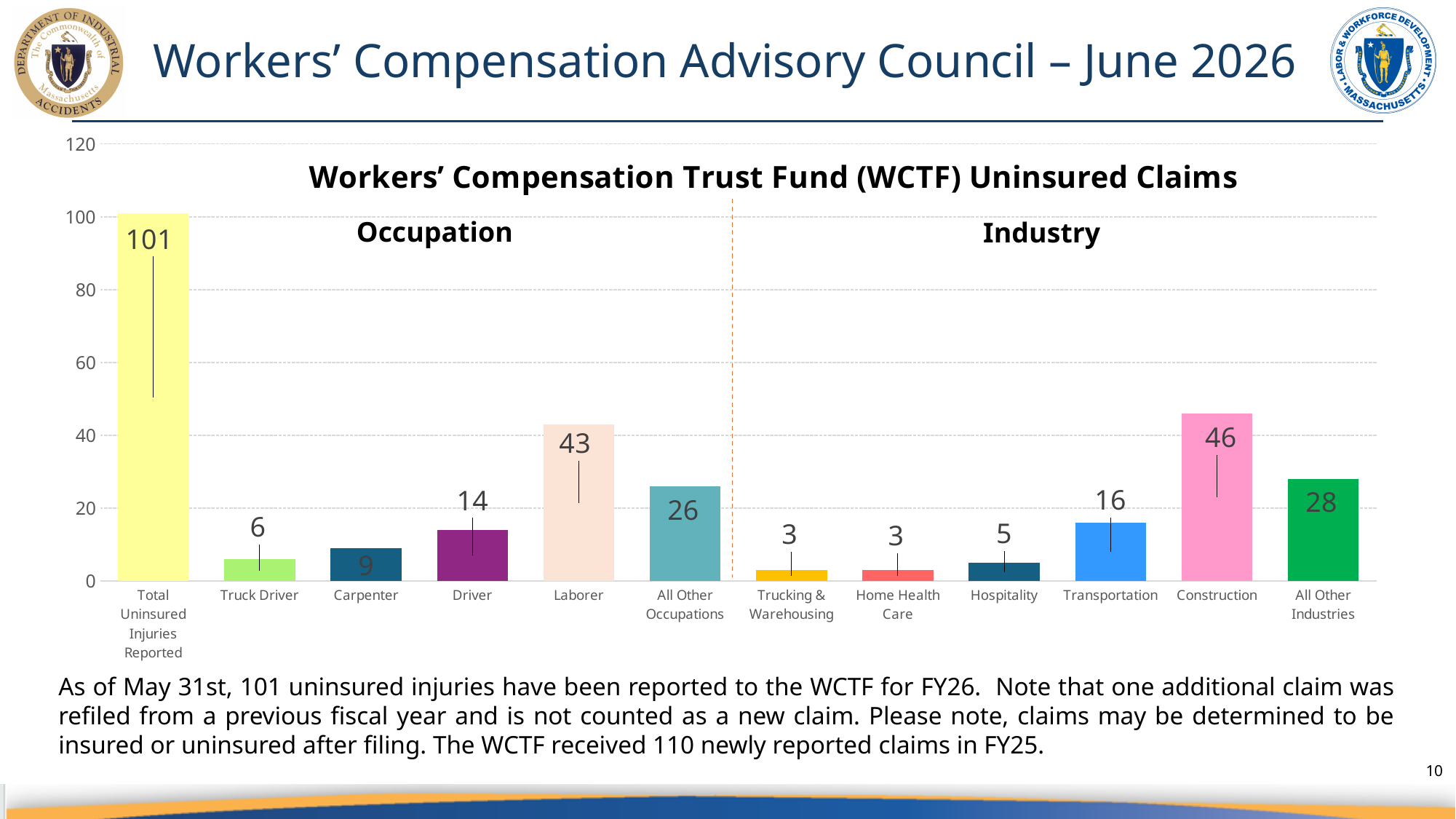
Which industry category has the highest value? Construction What kind of chart is shown on the slide? bar chart What is the difference between the values for Construction and Laborer? 3 Which occupation category has the lowest value? Truck Driver What is the value for Construction? 46 What is the value for Total Uninsured Injuries Reported? 101 What is the title of the chart? Workers' Compensation Trust Fund (WCTF) Uninsured Claims How many categories are plotted in the chart? 12 What is the difference between the values for Transportation and Driver? 2 What is the value for Carpenter? 9 What is the value for Laborer? 43 Which is larger, the value for All Other Industries or the value for All Other Occupations? All Other Industries